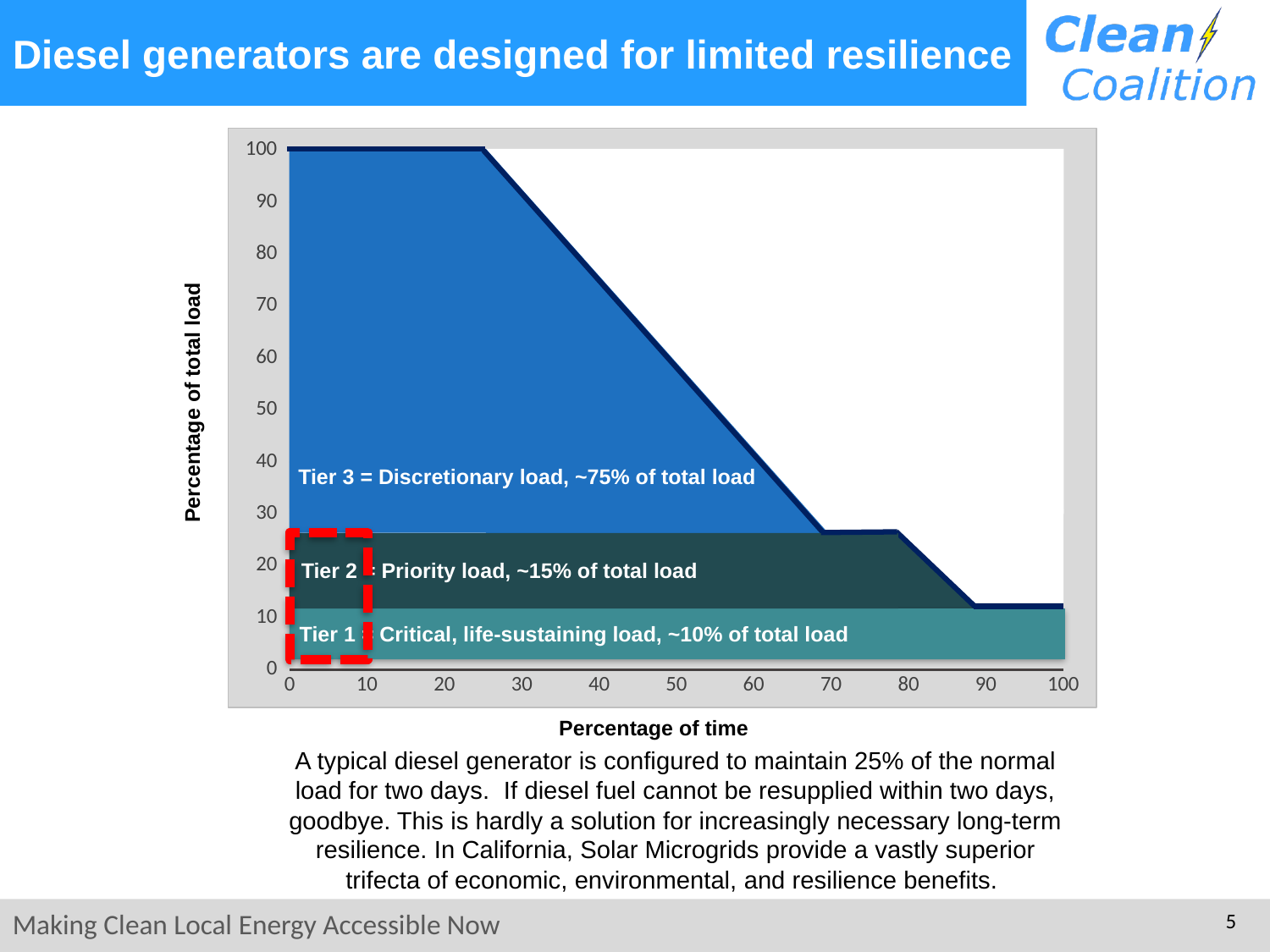
Is the percentage of total load at 50 percent of time greater or less than 50? greater Which is larger, the percentage of total load at 20 percent of time or at 80 percent of time? 20 percent of time What is the title of the y axis of the chart? Percentage of total load Does the percentage of total load rise or fall as the percentage of time increases? fall Is the percentage of total load at 30 percent of time greater or less than 80? greater What kind of chart is shown on the slide? area chart What is the percentage of total load at 0 percent of time? 100 Is the percentage of total load at 60 percent of time greater or less than 50? less What is the title of the x axis of the chart? Percentage of time How many load tiers are labelled on the chart? 3 What is the percentage of total load at 10 percent of time? 100